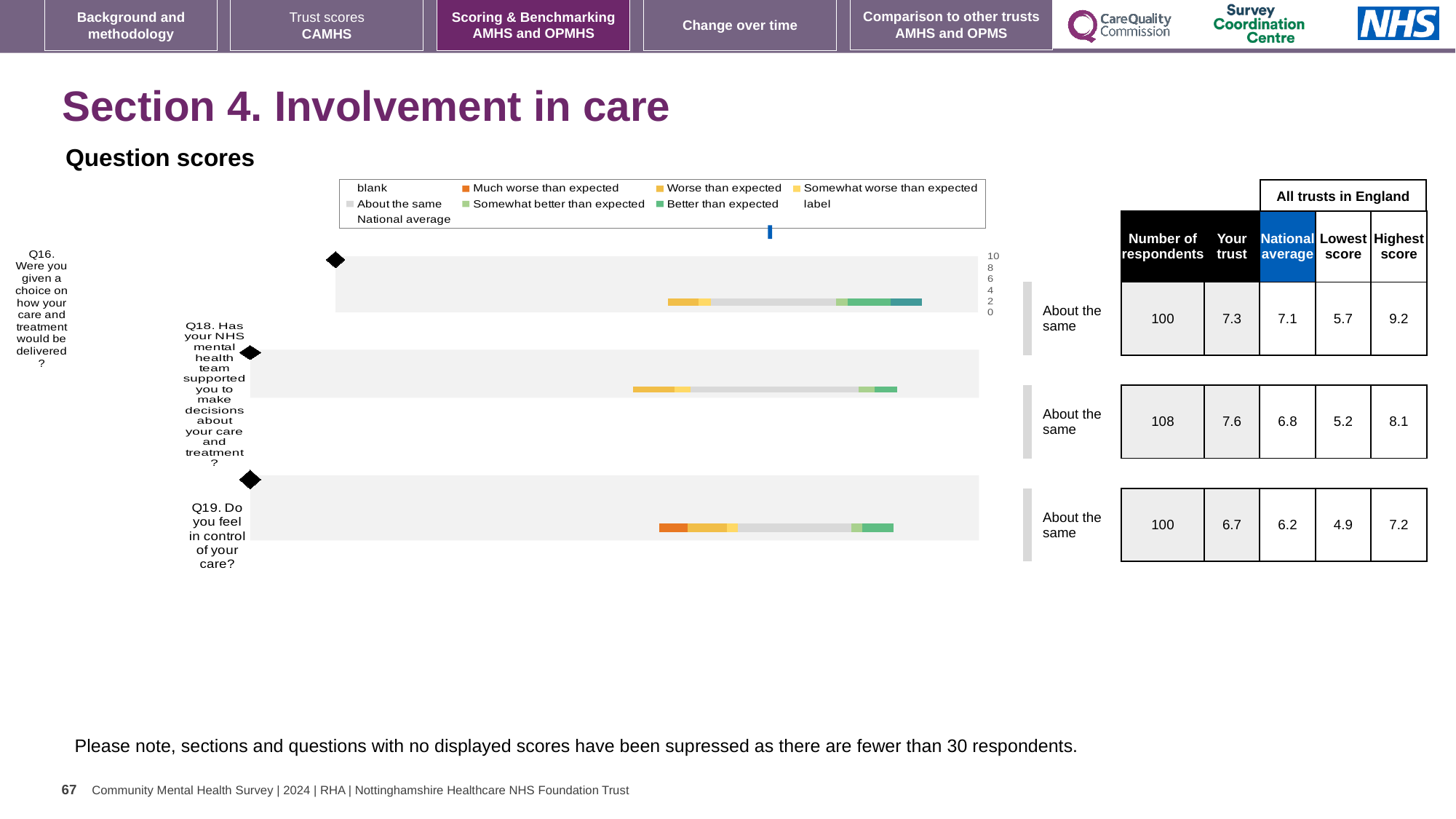
How many respondents answered Q18? 108 How many questions (Q16, Q18, Q19) are plotted on the slide? 3 What is the national average score for Q18 (Has your NHS mental health team supported you to make decisions about your care and treatment?)? 6.8 What is the difference between the 'Your trust' score and the national average for Q18? 0.8 Is the 'Your trust' score for Q19 higher or lower than the national average for Q19? higher What is the highest score across all trusts in England for Q16? 9.2 Which question has the highest 'Your trust' score: Q16, Q18 or Q19? Q18 What kind of chart is used to show the question scores for Q16, Q18 and Q19? bar chart What is the 'Your trust' score for Q16 (Were you given a choice on how your care and treatment would be delivered?)? 7.3 What is the 'Your trust' score for Q19 (Do you feel in control of your care?)? 6.7 What benchmark category label is shown next to each of the three question bars? About the same What is the lowest score across all trusts in England for Q19? 4.9